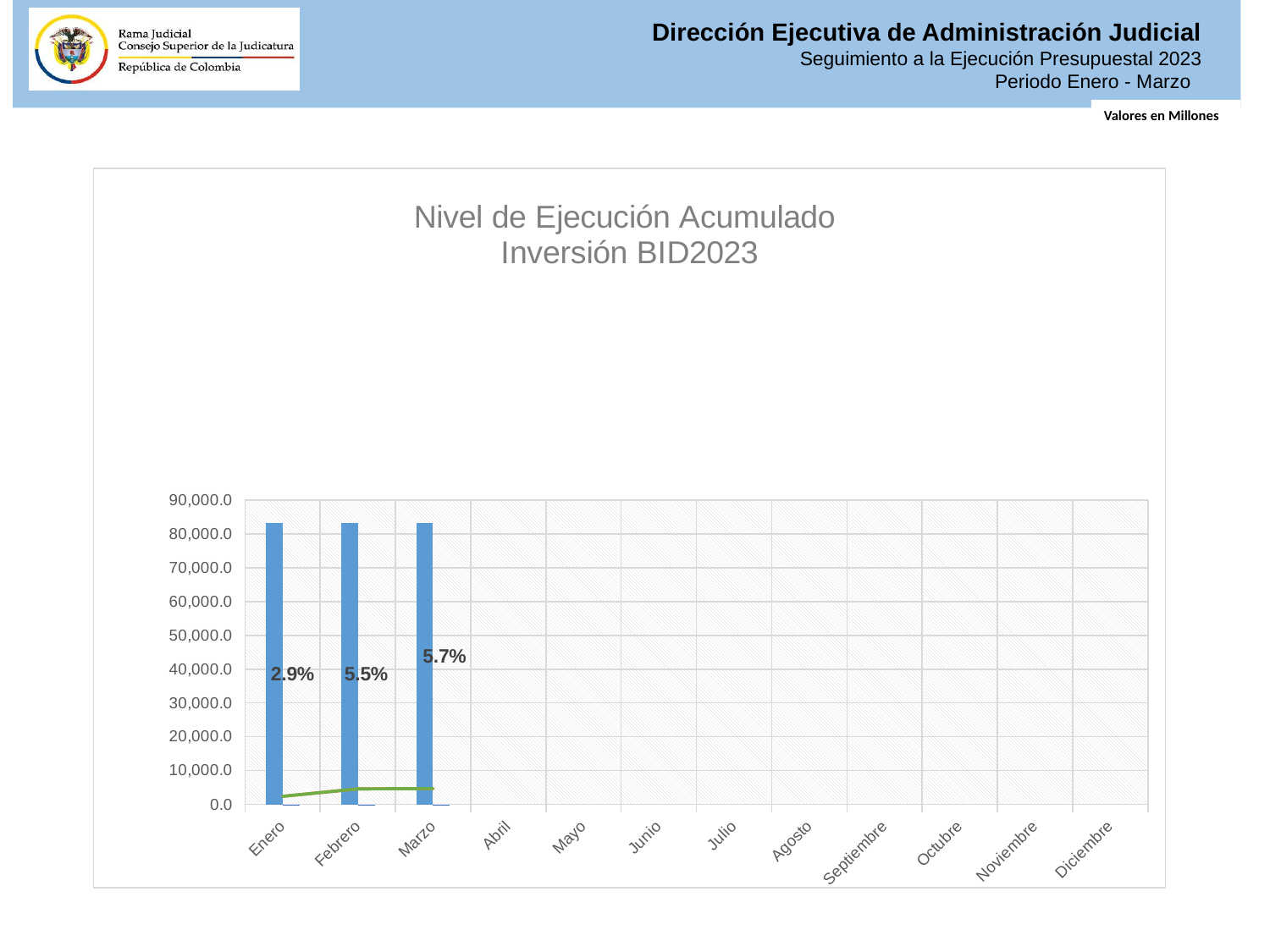
What is the difference between the percentage labels for Marzo and Enero? 2.8% How many months are listed on the x axis? 12 What kind of chart is shown? Bar chart with a line Which month has the lowest percentage label? Enero Which month has the highest percentage label? Marzo Which has the larger percentage label, Febrero or Marzo? Marzo What is the percentage label shown for Febrero? 5.5% Is the value of the blue bar for Enero greater or less than 80,000.0? greater Do the percentage labels rise or fall from Enero to Marzo? Rise What is the percentage label shown for Marzo? 5.7% What is the percentage label shown for Enero? 2.9% What is the title of the chart? Nivel de Ejecución Acumulado Inversión BID2023